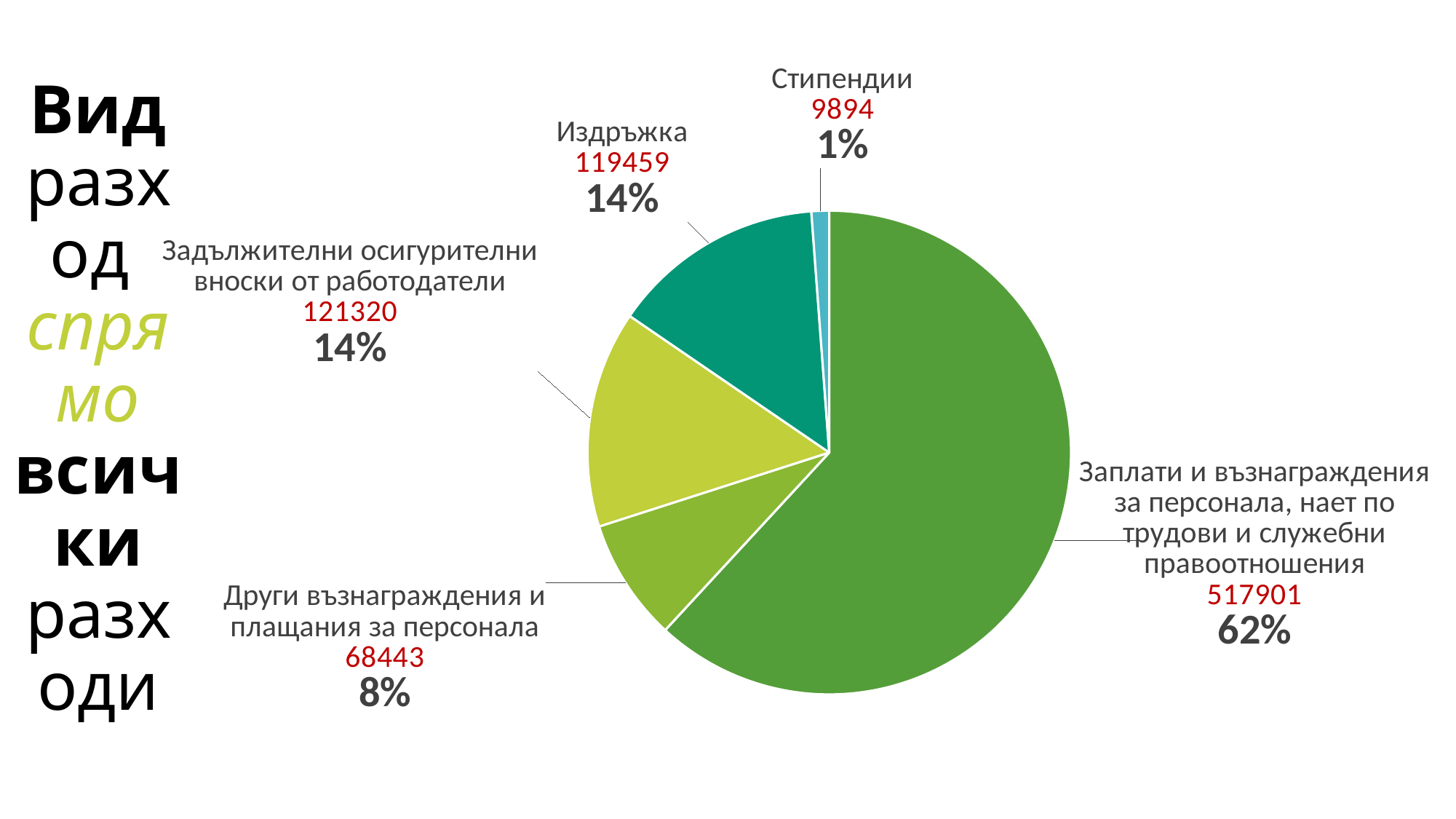
Which category has the smallest slice of the pie? Стипендии How many slices does the pie chart have? 5 What is the difference between the value for Заплати и възнаграждения за персонала, нает по трудови и служебни правоотношения and the value for Други възнаграждения и плащания за персонала? 449458 What is the value for Издръжка? 119459 What is the value for Стипендии? 9894 What is the value for Други възнаграждения и плащания за персонала? 68443 What is the value for Задължителни осигурителни вноски от работодатели? 121320 What share of the pie does Други възнаграждения и плащания за персонала represent? 8% What share of the pie does Заплати и възнаграждения за персонала, нает по трудови и служебни правоотношения represent? 62% Which category has the largest slice of the pie? Заплати и възнаграждения за персонала, нает по трудови и служебни правоотношения Which is larger: the value for Издръжка or the value for Задължителни осигурителни вноски от работодатели? Задължителни осигурителни вноски от работодатели What type of chart is shown on the slide? pie chart